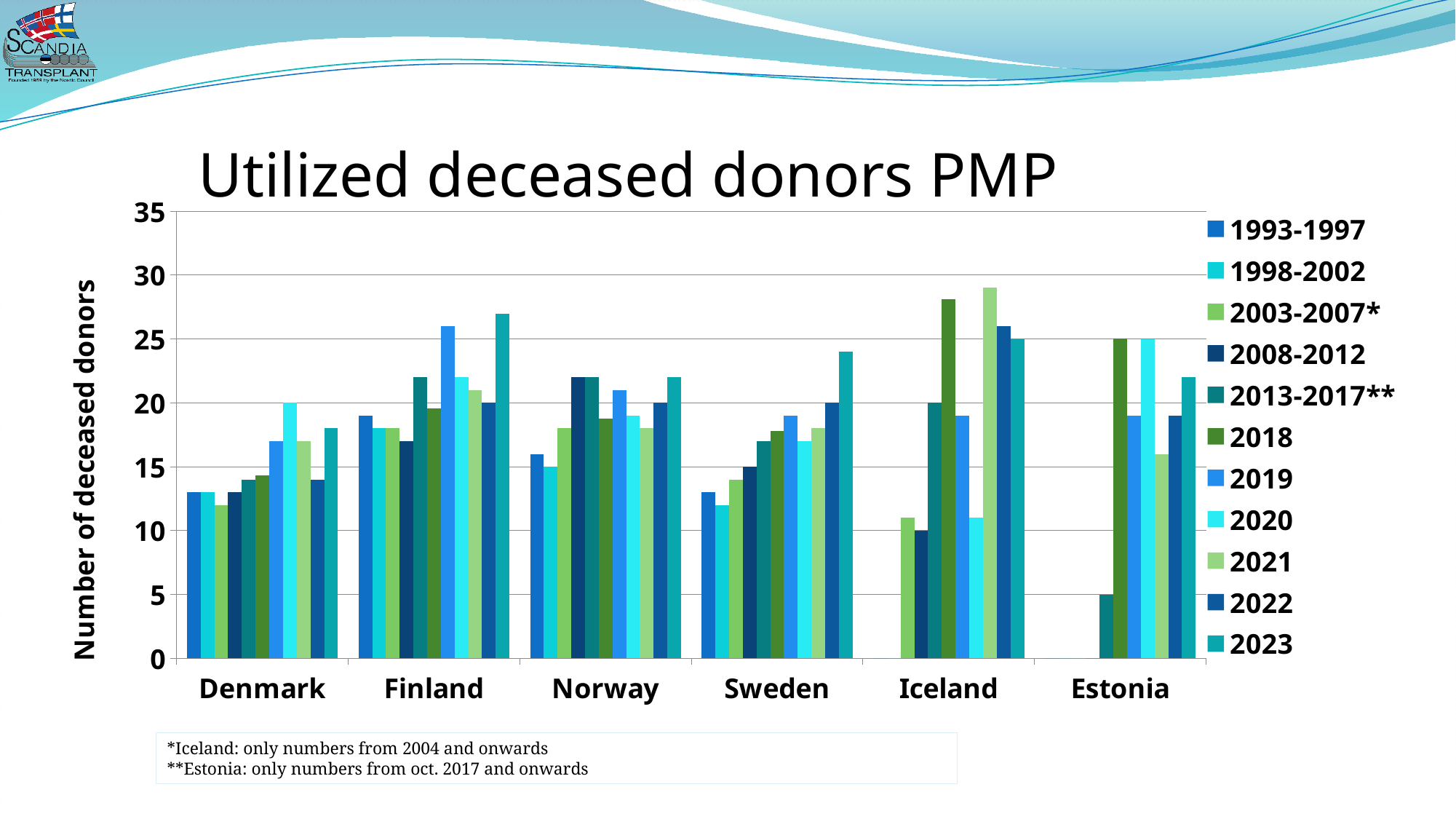
What is the label of the vertical axis? Number of deceased donors How many countries are shown on the x axis of the chart? 6 Which period has the highest value for Sweden? 2023 What type of chart is shown on the slide? bar chart Is the value for Iceland in 2021 greater or less than 25? greater Is the value for Finland in 2023 greater or less than 25? greater What is the title of the chart? Utilized deceased donors PMP Is the value for Denmark in 2003-2007* greater or less than 15? less In 2023, which country has the larger value, Sweden or Denmark? Sweden How many series (time periods) does the legend list? 11 Which period has the lowest value for Estonia? 2013-2017**